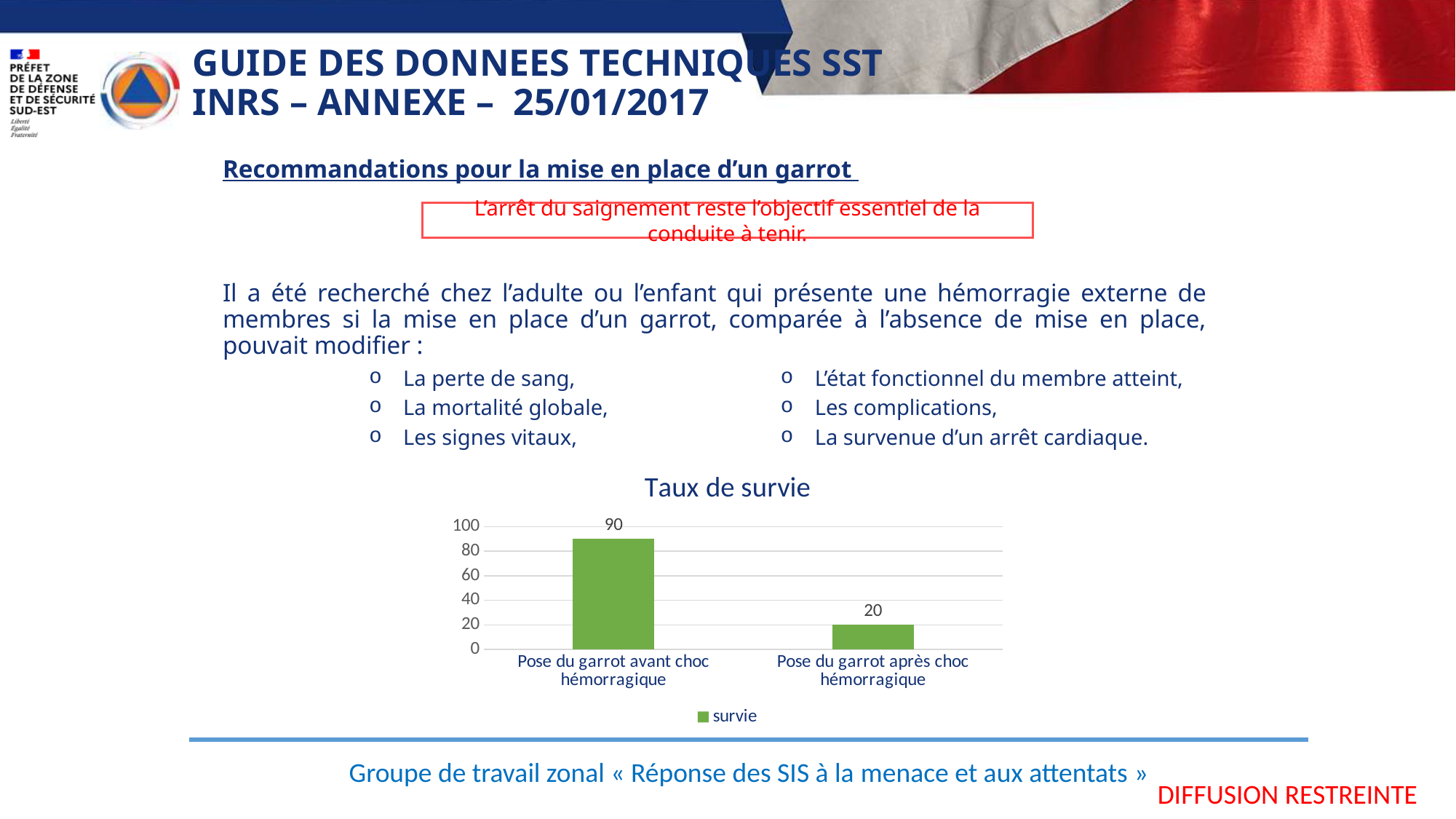
Which is larger: the value for "Pose du garrot avant choc hémorragique" or for "Pose du garrot après choc hémorragique"? Pose du garrot avant choc hémorragique How many categories are shown in the chart? 2 Which category has the highest value? Pose du garrot avant choc hémorragique How many series does the legend list? 1 What is the title of the chart? Taux de survie What is the difference between the values for "Pose du garrot avant choc hémorragique" and "Pose du garrot après choc hémorragique"? 70 Is the value for "Pose du garrot après choc hémorragique" greater or less than 40? less What kind of chart is shown on the slide? bar chart What is the value for "Pose du garrot avant choc hémorragique"? 90 Which category has the lowest value? Pose du garrot après choc hémorragique What is the value for "Pose du garrot après choc hémorragique"? 20 Is the value for "Pose du garrot avant choc hémorragique" greater or less than 80? greater